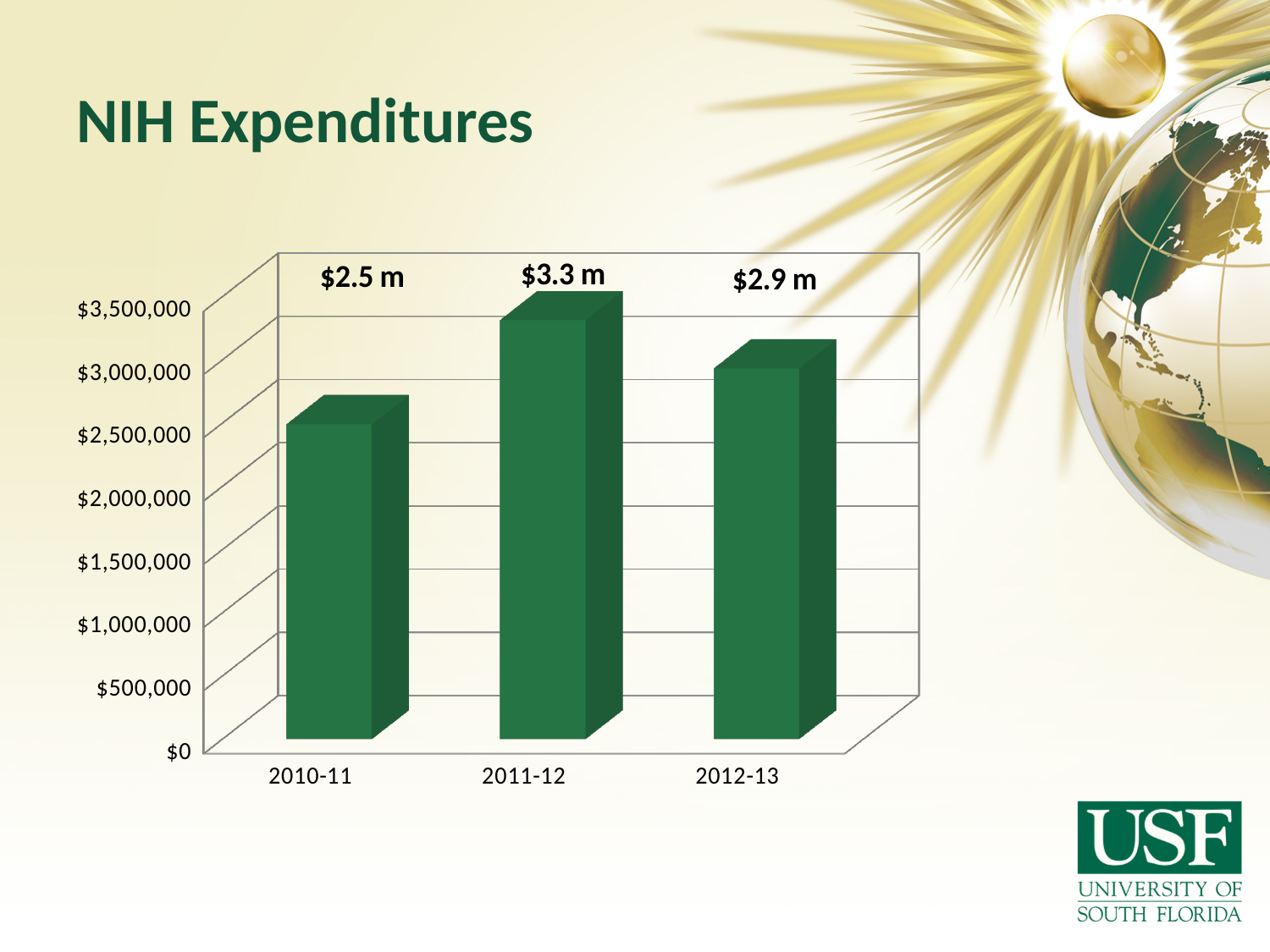
What is the NIH expenditure value labeled for 2010-11? $2.5 m Which year has the highest NIH expenditure? 2011-12 What is the difference between the labeled values for 2012-13 and 2010-11? $0.4 m How many years are shown on the x axis of the chart? 3 What is the difference between the labeled values for 2011-12 and 2010-11? $0.8 m Which is larger, the NIH expenditure for 2012-13 or for 2010-11? 2012-13 What kind of chart is shown on the slide? bar chart Is the value for 2011-12 greater or less than $3,000,000? greater What is the NIH expenditure value labeled for 2011-12? $3.3 m What is the NIH expenditure value labeled for 2012-13? $2.9 m Which year has the lowest NIH expenditure? 2010-11 What is the title of the chart on the slide? NIH Expenditures